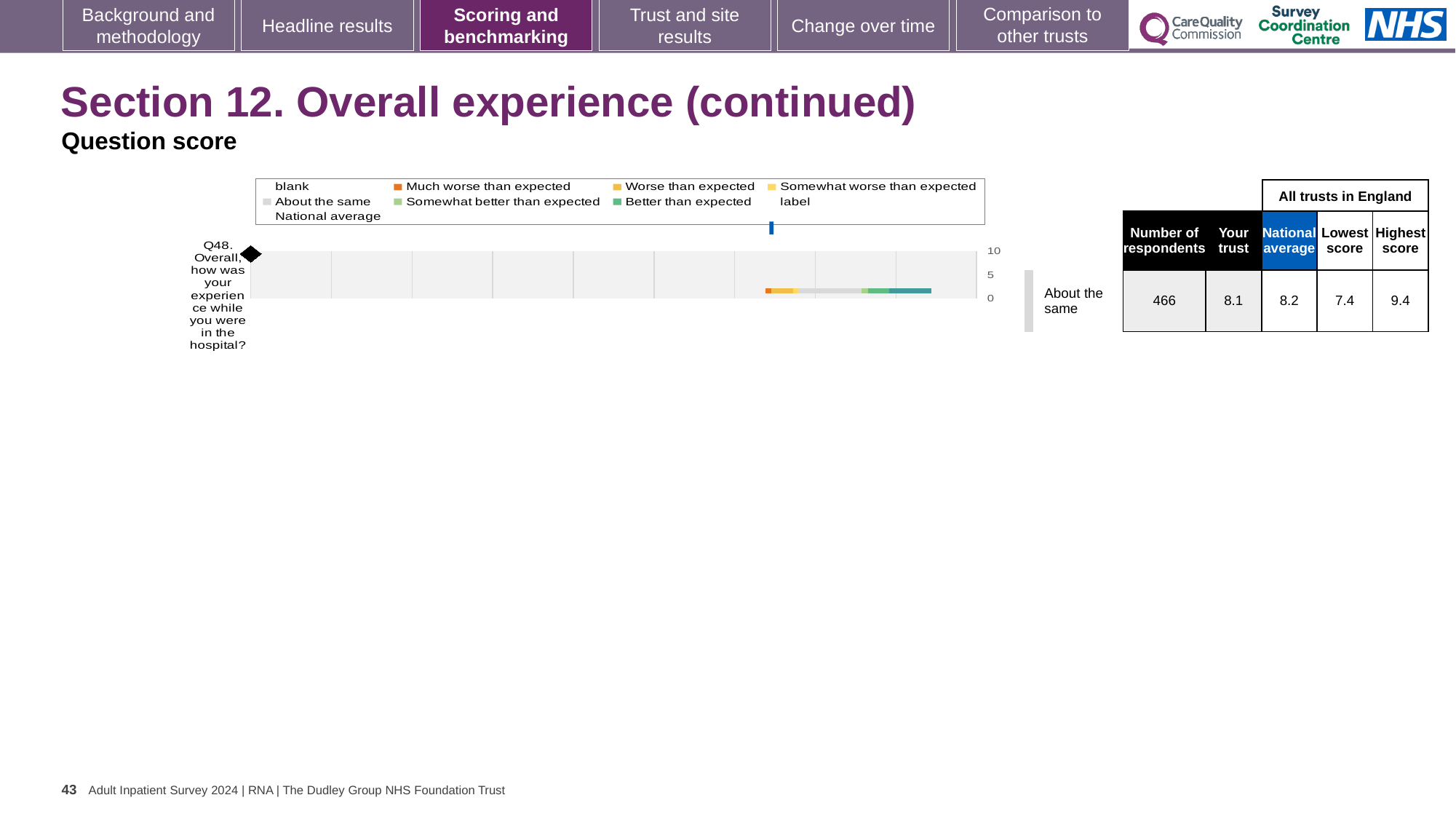
What is the difference between the highest score and the lowest score for Q48? 2.0 What is the national average score for Q48? 8.2 Which question is plotted on the chart? Q48. Overall, how was your experience while you were in the hospital? What is the highest score among all trusts in England for Q48? 9.4 What benchmark category is the trust's Q48 result placed in? About the same Which is larger for Q48, the 'Your trust' score or the national average? National average How many respondents answered Q48? 466 What is the 'Your trust' score for Q48? 8.1 How many survey questions are plotted on the chart? 1 What is the highest value shown on the chart's score axis? 10 What is the lowest score among all trusts in England for Q48? 7.4 What kind of chart is used to show the Q48 question score? bar chart